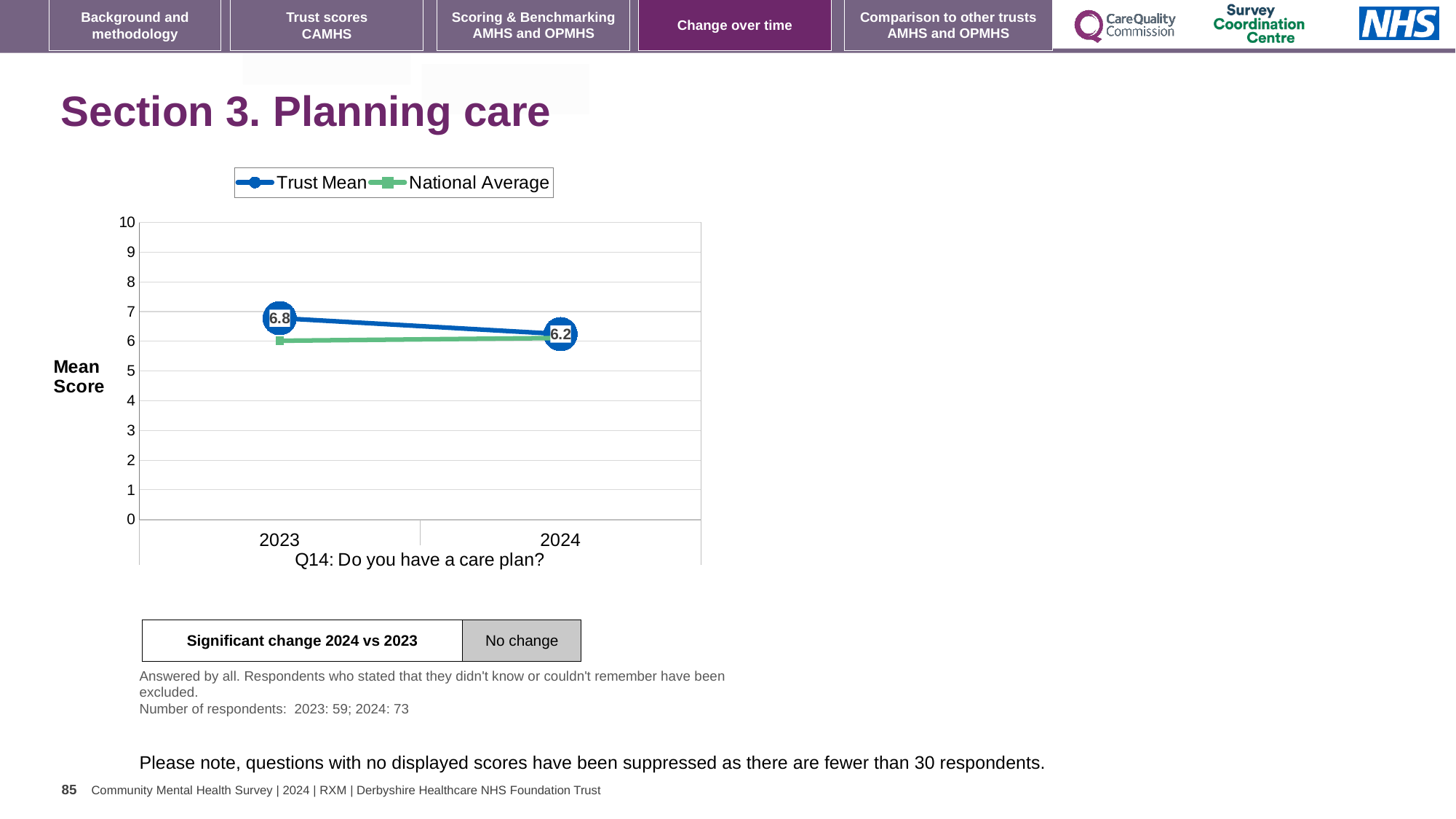
Is the National Average value for 2024 greater or less than 5? greater In which year is the Trust Mean higher? 2023 What is the Trust Mean score for 2023? 6.8 In 2023, which is larger: the Trust Mean or the National Average? Trust Mean How many years are shown on the x axis? 2 By how much did the Trust Mean score change from 2023 to 2024? 0.6 What is the Trust Mean score for 2024? 6.2 Is the National Average value for 2023 greater or less than 7? less Does the Trust Mean rise or fall from 2023 to 2024? fall What is the label on the y axis of the chart? Mean Score What kind of chart is shown on the slide? line chart How many series does the legend list? 2